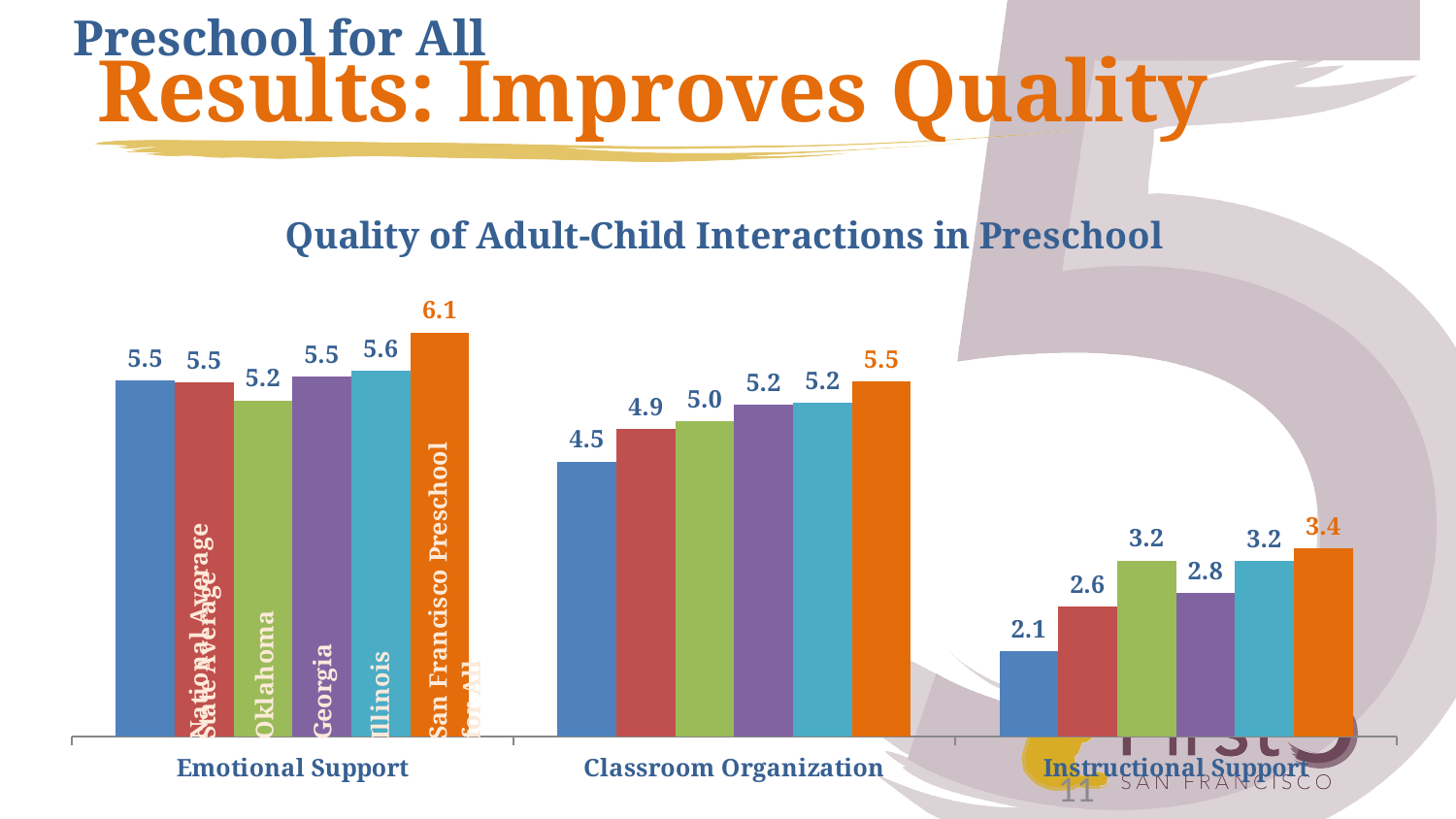
Which series has the lowest value in the Emotional Support category? Oklahoma What is the value for Oklahoma in the Classroom Organization category? 5.0 In the Instructional Support category, which is larger: the value for Georgia or the value for Illinois? Illinois How many categories are shown along the x axis of the chart? 3 What is the value for Georgia in the Classroom Organization category? 5.2 What type of chart is shown on the slide? bar chart What is the title of the chart? Quality of Adult-Child Interactions in Preschool What is the highest value shown anywhere on the chart? 6.1 What is the value for San Francisco Preschool for All in the Emotional Support category? 6.1 What is the value for Illinois in the Instructional Support category? 3.2 What is the difference between the San Francisco Preschool for All value and the Oklahoma value in the Emotional Support category? 0.9 Which series has the highest value in the Instructional Support category? San Francisco Preschool for All